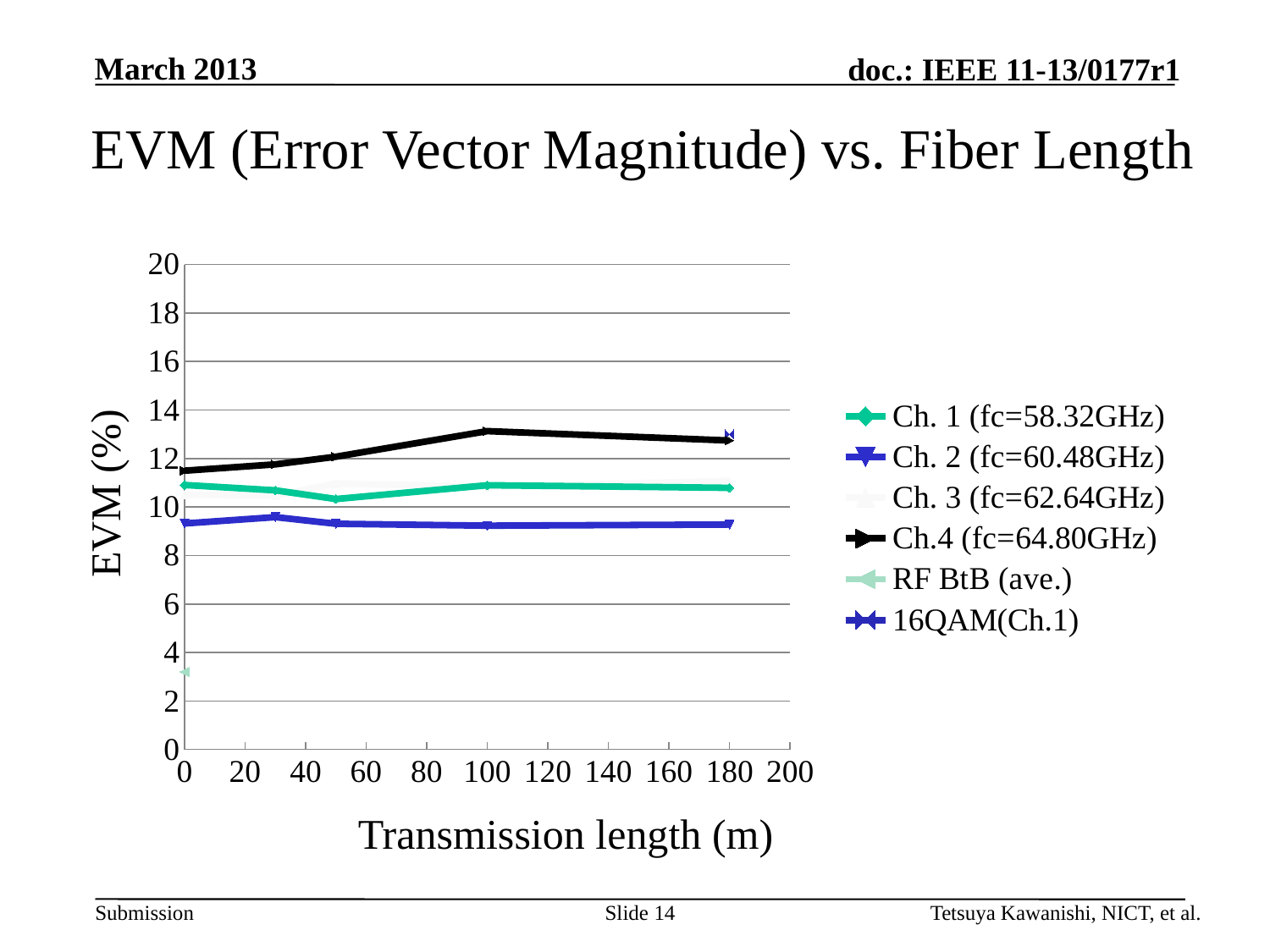
What is the label of the x axis? Transmission length (m) At 100 m, which is larger: Ch.4 (fc=64.80GHz) or Ch. 2 (fc=60.48GHz)? Ch.4 (fc=64.80GHz) Is the value for Ch.4 (fc=64.80GHz) at 100 m greater or less than 12? greater How many series does the legend list? 6 Is the value for Ch. 2 (fc=60.48GHz) at 100 m greater or less than 10? less Is the value for RF BtB (ave.) at 0 m greater or less than 4? less What is the title of the chart? EVM (Error Vector Magnitude) vs. Fiber Length Which series has the highest EVM at 100 m? Ch.4 (fc=64.80GHz) Does the Ch.4 (fc=64.80GHz) line rise or fall between 0 m and 100 m? rise At 50 m, which is larger: Ch. 1 (fc=58.32GHz) or Ch. 2 (fc=60.48GHz)? Ch. 1 (fc=58.32GHz) What kind of chart is shown on the slide? line chart